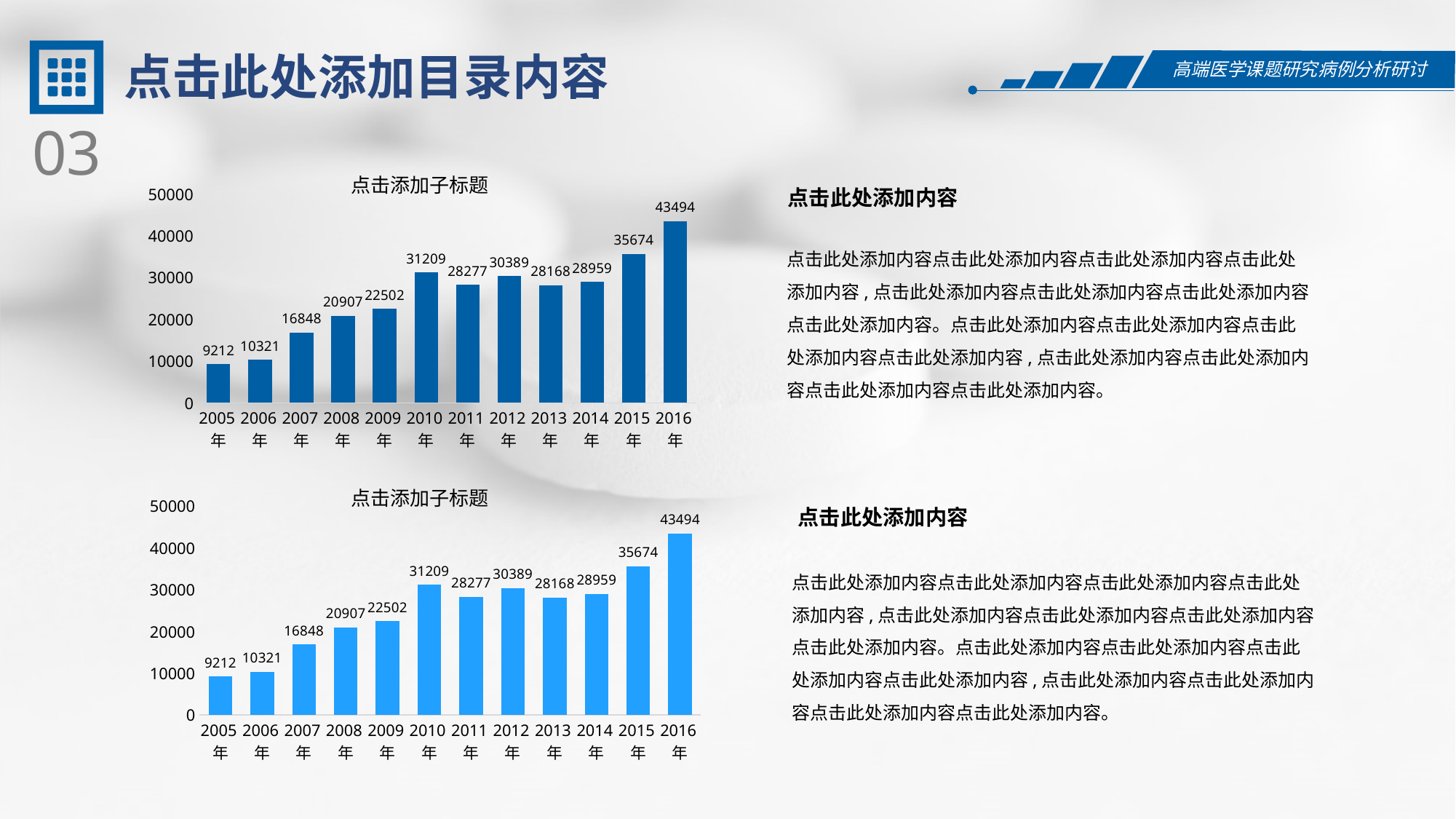
In the top chart, what is the difference between the values for 2006年 and 2005年? 1109 What kind of chart is the top chart? bar chart In the bottom chart, which is larger, the value for 2011年 or the value for 2012年? 2012年 In the bottom chart, do the values rise or fall from 2005年 to 2010年? rise In the bottom chart, what is the value for 2008年? 20907 In the top chart, what is the difference between the values for 2016年 and 2015年? 7820 In the bottom chart, which year has the lowest value? 2005年 What is the title of the bottom chart? 点击添加子标题 In the top chart, which year has the highest value? 2016年 In the top chart, what is the value for 2010年? 31209 How many years are shown on the x axis of the bottom chart? 12 In the top chart, is the value for 2009年 greater or less than 20000? greater